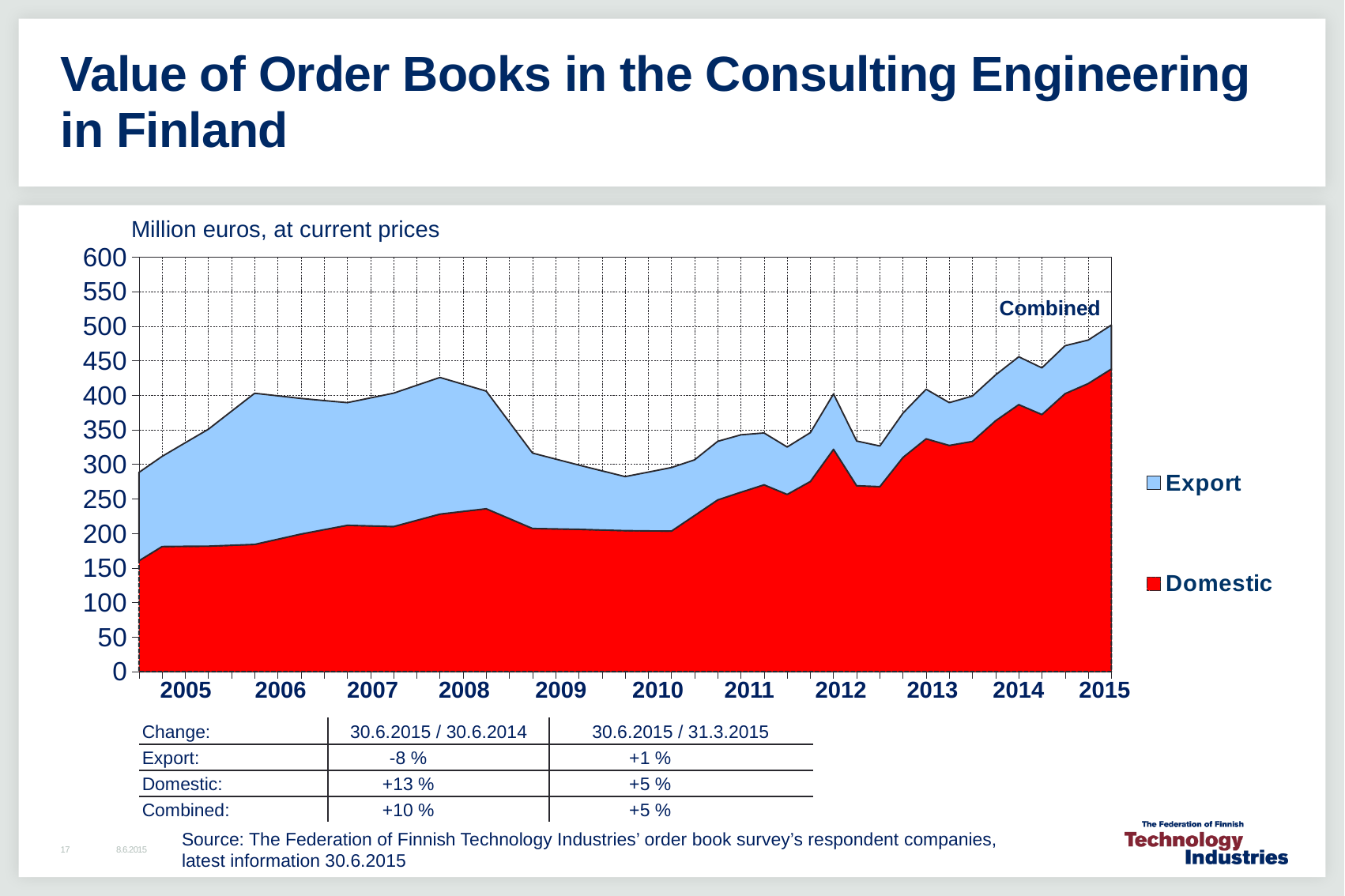
Does the Domestic value rise or fall overall from 2005 to 2015? rise In which year does the Combined value reach its highest level? 2015 Is the Domestic value larger in 2015 or in 2005? 2015 What kind of chart is shown on the slide? Stacked area chart How many series does the chart's legend list? 2 Is the Domestic value at 2015 greater or less than 400? greater How many year labels appear on the x axis of the chart? 11 Is the Domestic value at the start of 2005 greater or less than 200? less Which two series are listed in the chart's legend? Export and Domestic Is the Combined value at 2008 greater or less than 400? greater What unit is stated above the chart's y axis? Million euros, at current prices